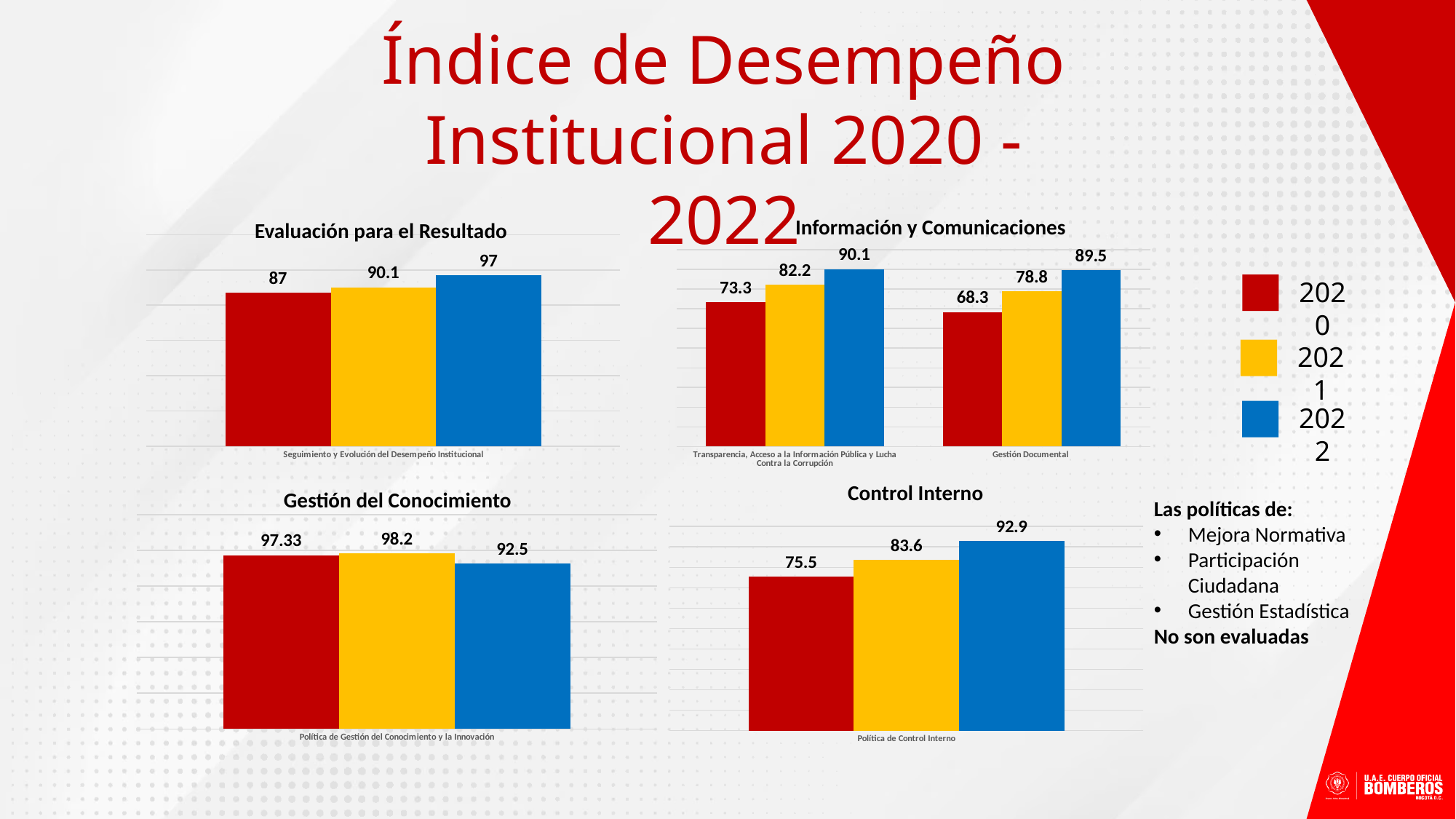
In the 'Información y Comunicaciones' chart, which bar has the lowest value? 2020 for Gestión Documental In the 'Información y Comunicaciones' chart, which is larger: the 2022 value for Transparencia, Acceso a la Información Pública y Lucha Contra la Corrupción or the 2022 value for Gestión Documental? Transparencia, Acceso a la Información Pública y Lucha Contra la Corrupción In the 'Control Interno' chart, do the values rise or fall from 2020 to 2022? rise In the 'Información y Comunicaciones' chart, what is the 2020 value for Transparencia, Acceso a la Información Pública y Lucha Contra la Corrupción? 73.3 In the 'Información y Comunicaciones' chart, what is the 2021 value for Gestión Documental? 78.8 In the 'Control Interno' chart, what is the difference between the 2022 value and the 2020 value? 17.4 In the 'Gestión del Conocimiento' chart, which year has the highest value? 2021 In the 'Gestión del Conocimiento' chart, what is the difference between the 2021 value and the 2022 value? 5.7 In the 'Evaluación para el Resultado' chart, what is the value for 2022? 97 In the 'Evaluación para el Resultado' chart, what is the value for 2020? 87 What kind of chart is 'Control Interno'? bar chart How many series does the legend list? 3